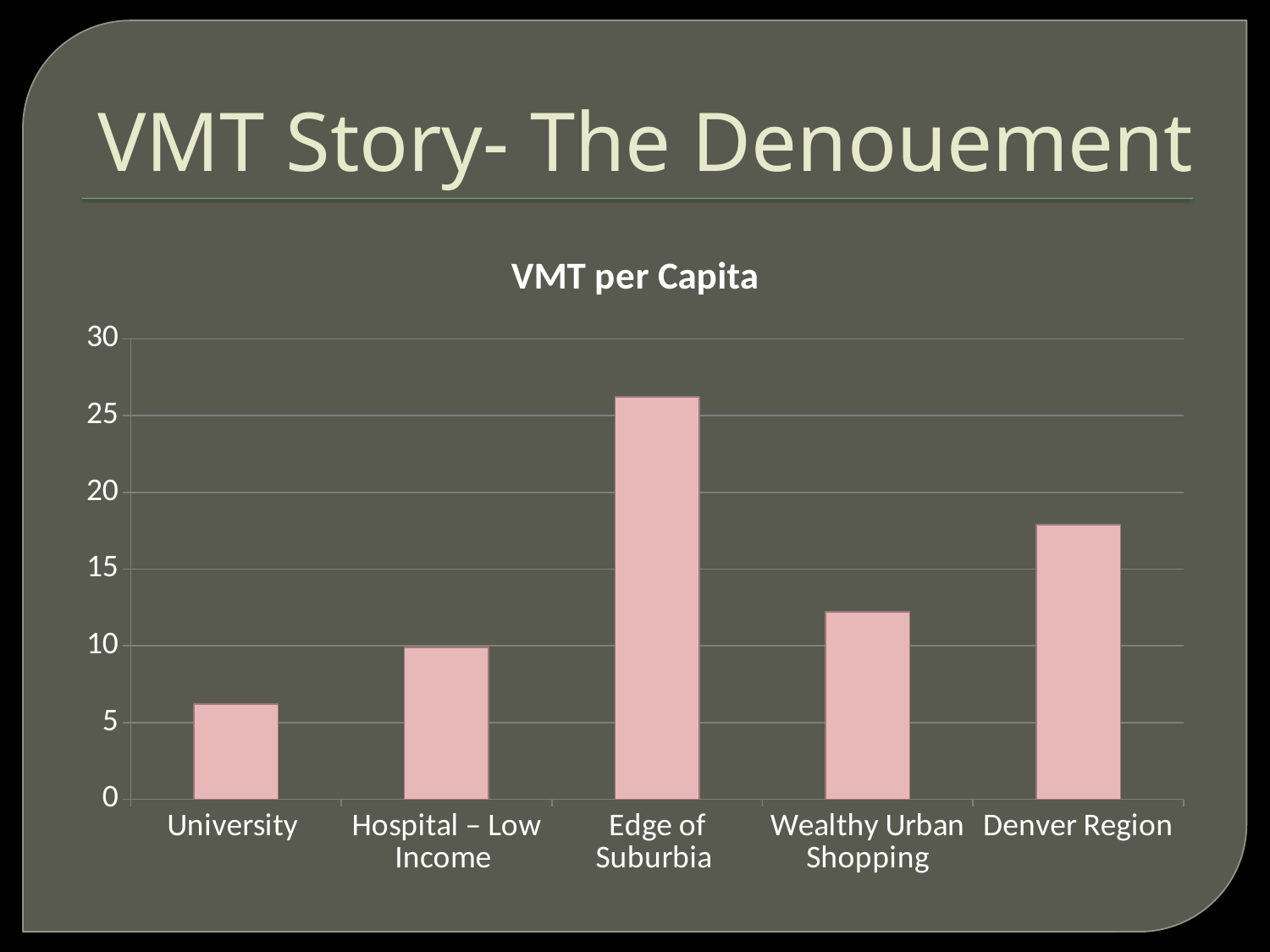
Which is larger, the value for Denver Region or the value for Wealthy Urban Shopping? Denver Region How many categories are shown on the x axis of the chart? 5 What is the title of the chart? VMT per Capita What kind of chart is shown on the slide? bar chart Is the value for Denver Region greater or less than 20? less Is the value for Edge of Suburbia greater or less than 25? greater Is the value for Hospital – Low Income greater or less than 15? less Which category has the lowest VMT per Capita? University Which category has the highest VMT per Capita? Edge of Suburbia Which is larger, the value for University or the value for Hospital – Low Income? Hospital – Low Income